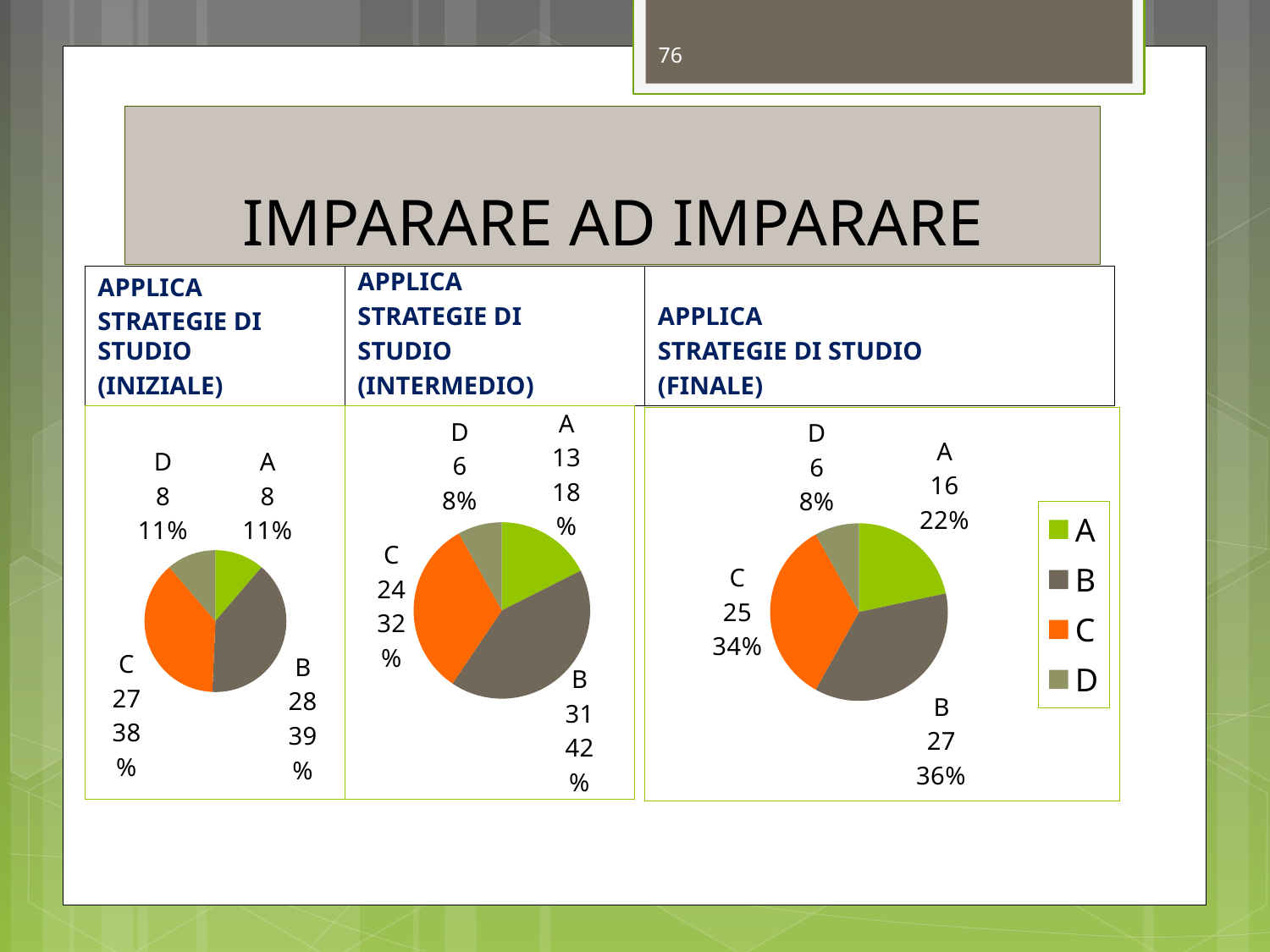
How many categories does the APPLICA STRATEGIE DI STUDIO (INIZIALE) chart show? 4 In the APPLICA STRATEGIE DI STUDIO (FINALE) chart, what percentage share does category A have? 22% In the APPLICA STRATEGIE DI STUDIO (FINALE) chart, what is the value for category D? 6 What kind of chart is used for APPLICA STRATEGIE DI STUDIO (FINALE)? Pie chart In the APPLICA STRATEGIE DI STUDIO (INTERMEDIO) chart, what is the value for category A? 13 In the APPLICA STRATEGIE DI STUDIO (INTERMEDIO) chart, which category has the largest slice? B In the APPLICA STRATEGIE DI STUDIO (INIZIALE) chart, what percentage share does category B have? 39% In the legend next to the APPLICA STRATEGIE DI STUDIO (FINALE) chart, which category is shown in orange? C In the APPLICA STRATEGIE DI STUDIO (FINALE) chart, what is the difference between the values for B and C? 2 In the APPLICA STRATEGIE DI STUDIO (FINALE) chart, which is larger, the value for B or the value for A? B In the APPLICA STRATEGIE DI STUDIO (INIZIALE) chart, what is the value for category C? 27 In the APPLICA STRATEGIE DI STUDIO (INTERMEDIO) chart, which category has the smallest slice? D